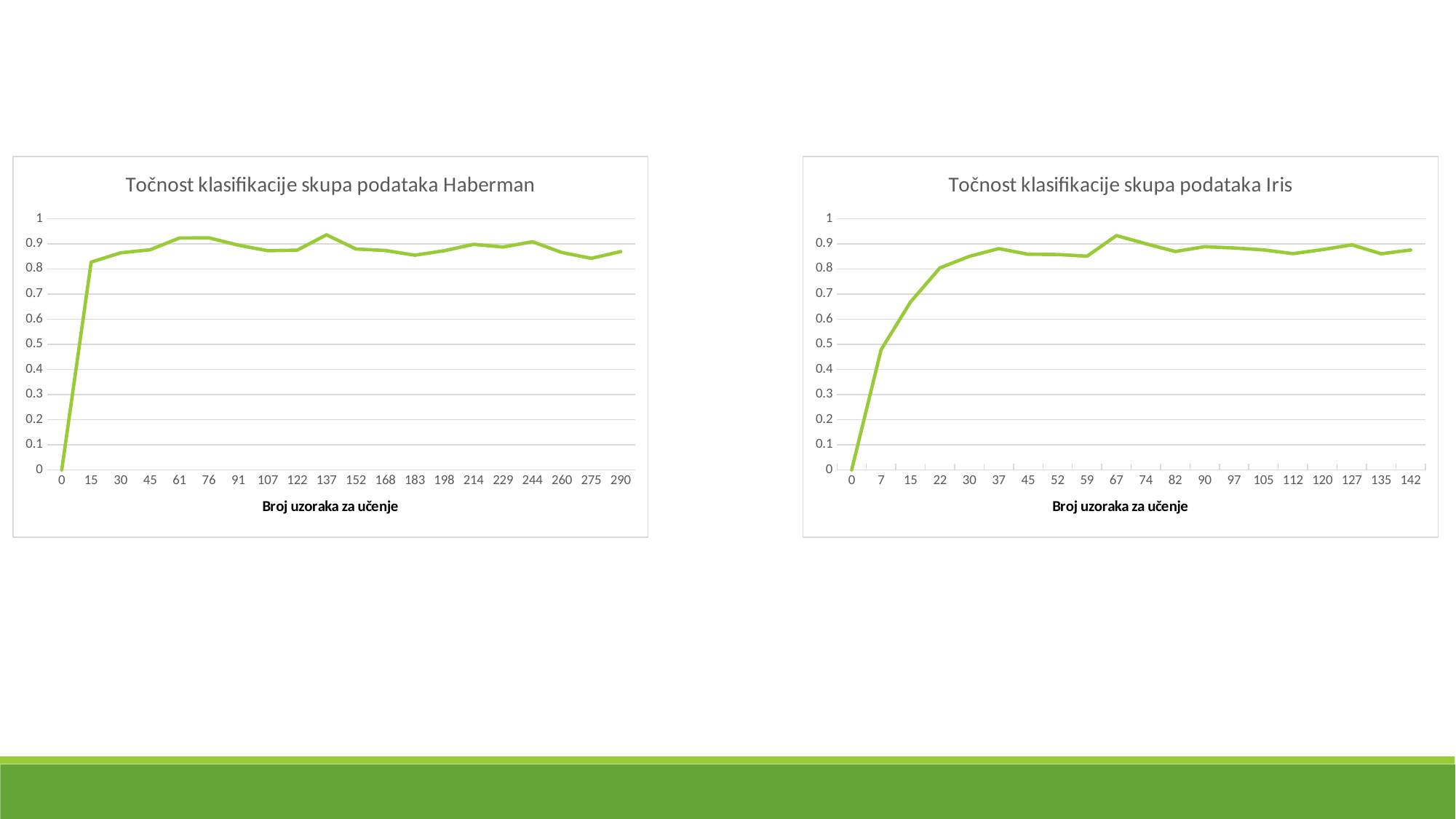
In the 'Točnost klasifikacije skupa podataka Haberman' chart, how many points are plotted along the x axis? 20 In the 'Točnost klasifikacije skupa podataka Haberman' chart, what is the value at 0 samples? 0 In the 'Točnost klasifikacije skupa podataka Iris' chart, which is larger: the value at 7 samples or at 15 samples? 15 samples In the 'Točnost klasifikacije skupa podataka Iris' chart, what is the x-axis title? Broj uzoraka za učenje In the 'Točnost klasifikacije skupa podataka Iris' chart, is the value at 67 samples greater or less than 0.9? greater In the 'Točnost klasifikacije skupa podataka Haberman' chart, at which number of samples is the accuracy lowest? 0 In the 'Točnost klasifikacije skupa podataka Iris' chart, is the value at 7 samples greater or less than 0.5? less In the 'Točnost klasifikacije skupa podataka Iris' chart, how does the accuracy change as the number of samples increases from 0 to 37? it rises In the 'Točnost klasifikacije skupa podataka Iris' chart, how many points are plotted along the x axis? 20 In the 'Točnost klasifikacije skupa podataka Iris' chart, at which number of samples is the accuracy highest? 67 In the 'Točnost klasifikacije skupa podataka Haberman' chart, is the value at 15 samples greater or less than 0.8? greater What kind of chart is the left chart titled 'Točnost klasifikacije skupa podataka Haberman'? line chart